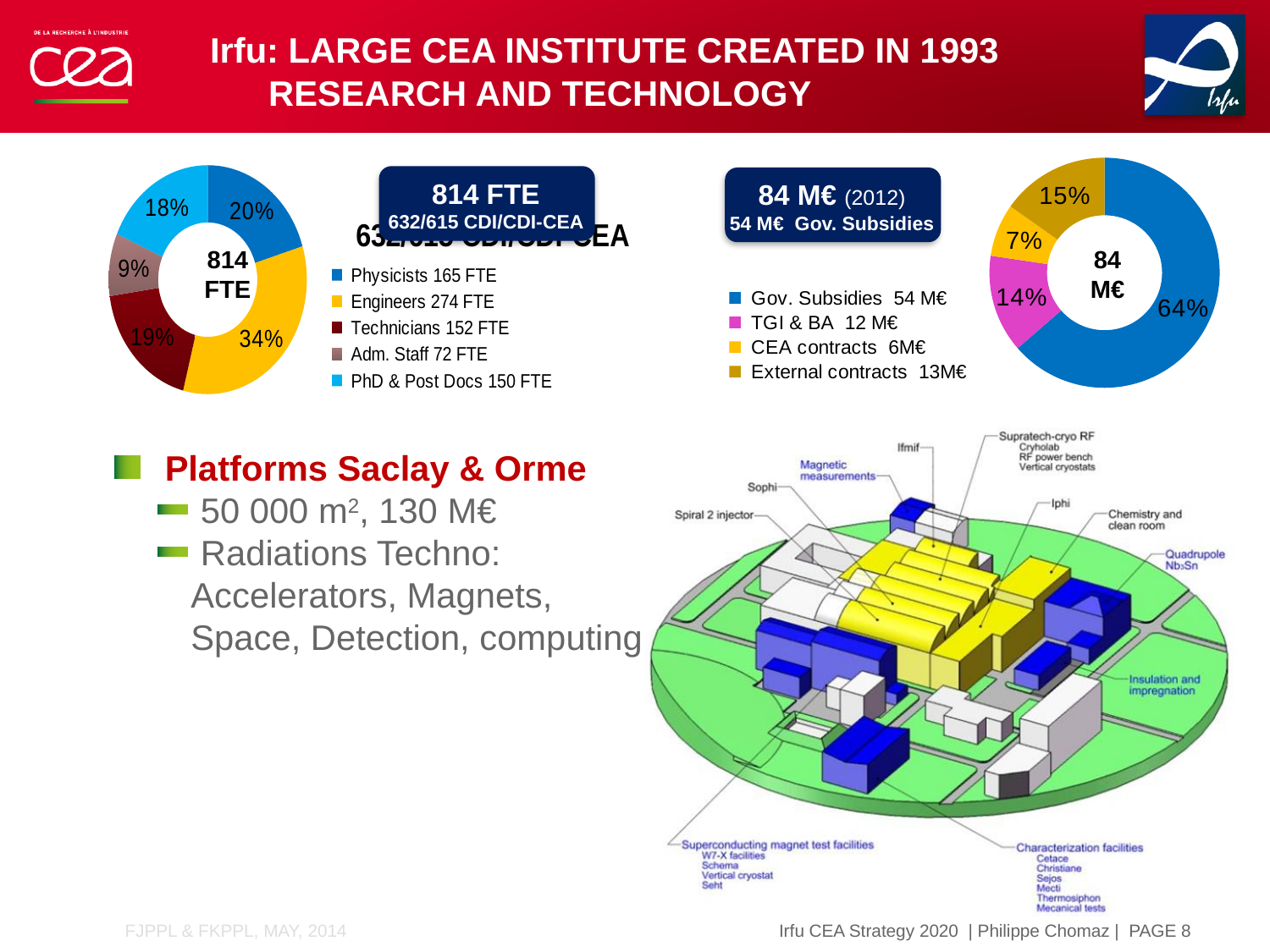
What type of chart is used to show the 84 M€ budget breakdown on the right? Donut (pie) chart In the 814 FTE donut chart on the left, which category has the smallest share? Adm. Staff In the 84 M€ donut chart on the right, what percentage share do Gov. Subsidies have? 64% In the 814 FTE chart on the left, what is the difference in FTE between Engineers and Physicists? 109 FTE In the 84 M€ chart on the right, which is larger: TGI & BA or External contracts? External contracts In the 84 M€ donut chart on the right, which category has the smallest share? CEA contracts In the 814 FTE donut chart on the left, which category has the largest share? Engineers According to the legend of the 814 FTE chart on the left, how many FTE are Technicians? 152 FTE How many categories does the legend of the 814 FTE chart on the left list? 5 How many categories does the legend of the 84 M€ chart on the right list? 4 According to the legend of the 84 M€ chart on the right, what is the value for External contracts? 13M€ In the 814 FTE donut chart on the left, what percentage share do Engineers have? 34%